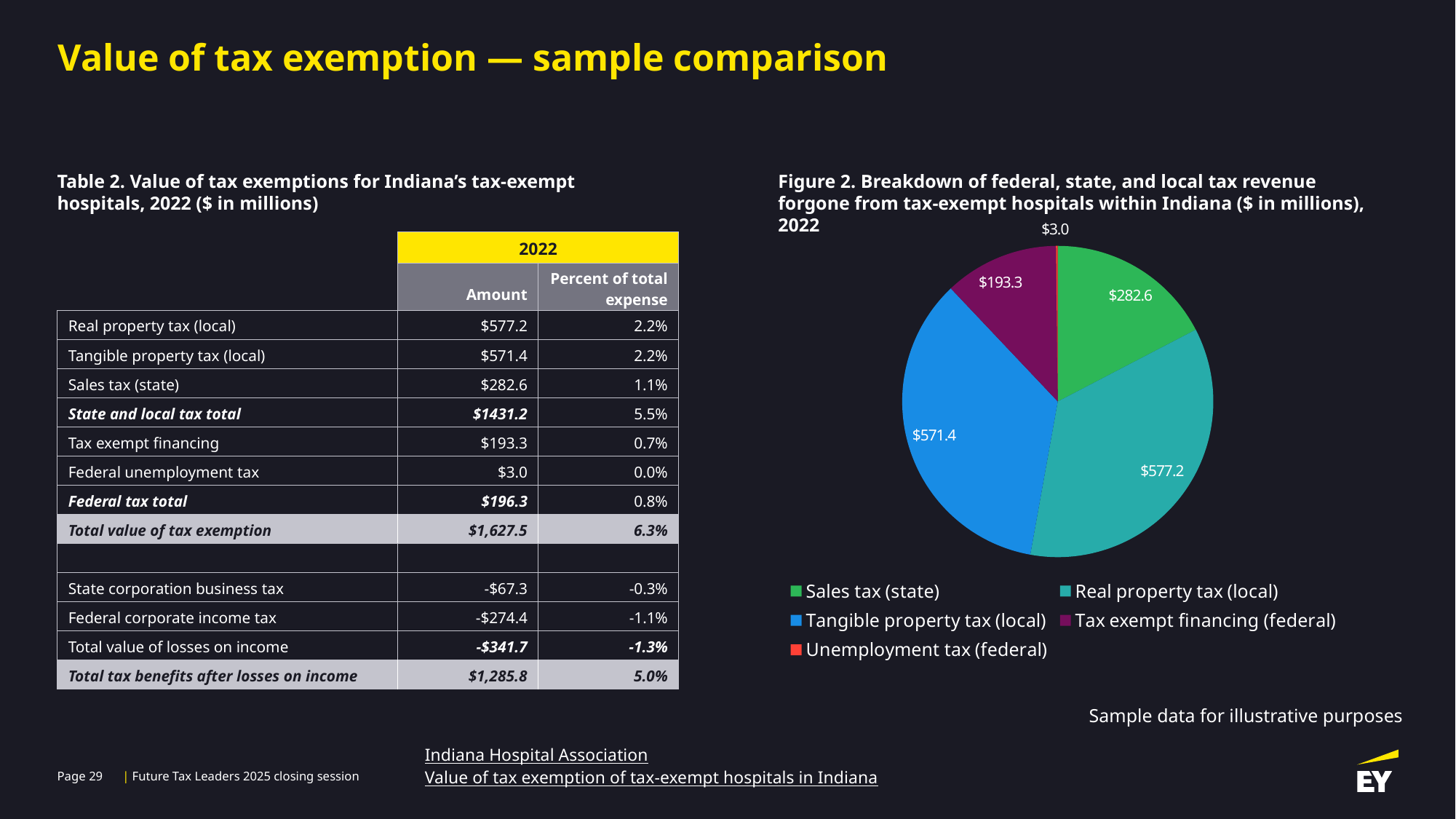
In the pie chart, what is the difference between Sales tax (state) and Tax exempt financing (federal)? $89.3 In the pie chart, which is larger: Tangible property tax (local) or Sales tax (state)? Tangible property tax (local) In the pie chart, what is the value for Tax exempt financing (federal)? $193.3 In the pie chart, what is the difference between Real property tax (local) and Tangible property tax (local)? $5.8 In the pie chart, what is the value for Real property tax (local)? $577.2 What type of chart is Figure 2 on the slide? Pie chart In the pie chart, what is the value for Sales tax (state)? $282.6 What colour is the Sales tax (state) slice in the pie chart? Green Which category has the largest slice in the pie chart? Real property tax (local) How many slices does the pie chart have? 5 Which category has the smallest slice in the pie chart? Unemployment tax (federal) How many entries does the legend of the pie chart list? 5